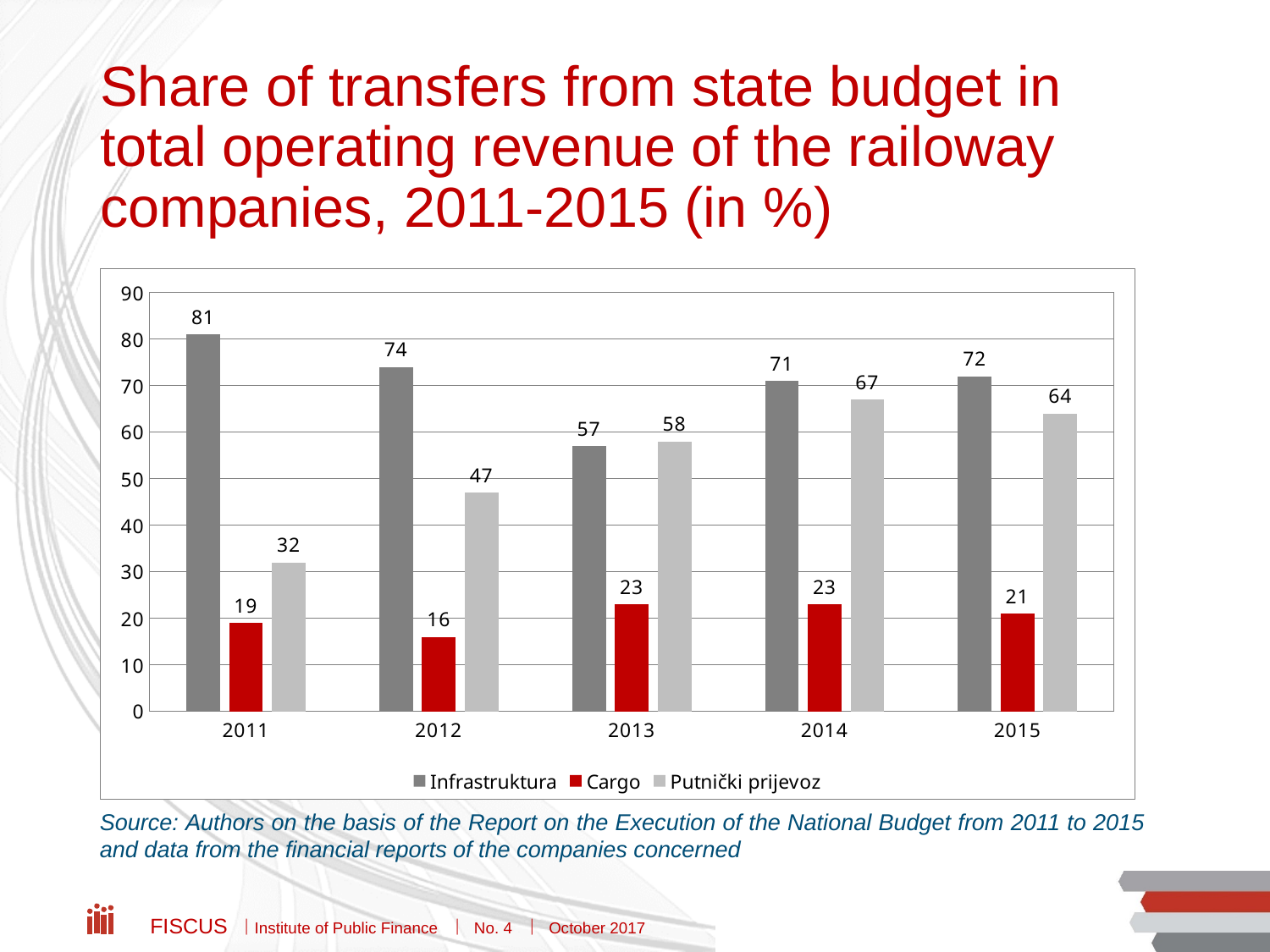
Which is larger in 2013, Infrastruktura or Putnički prijevoz? Putnički prijevoz What is the difference between the Infrastruktura and Cargo values in 2015? 51 Which series is shown in red in the legend? Cargo What is the value for Putnički prijevoz in 2014? 67 In which year is the Infrastruktura value lowest? 2013 In which year is the Putnički prijevoz value highest? 2014 What kind of chart is shown on the slide? Bar chart How many years are shown on the x axis? 5 What is the value for Cargo in 2012? 16 What is the value for Infrastruktura in 2011? 81 How many series does the legend list? 3 Does the Putnički prijevoz value rise or fall from 2011 to 2014? Rise